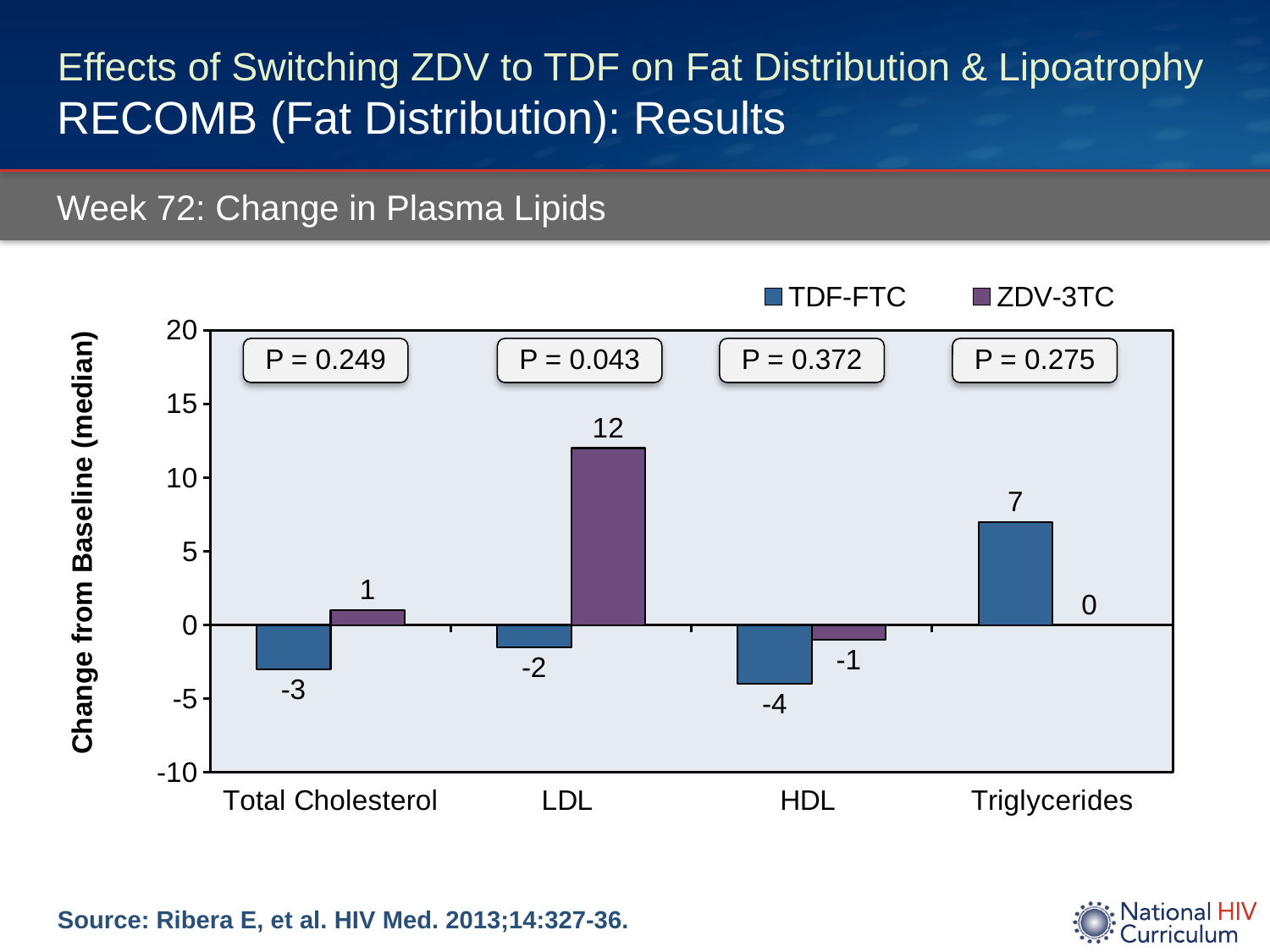
What is the change from baseline for ZDV-3TC in HDL? -1 How many categories are shown on the x axis? 4 What P value is shown above the LDL bars? P = 0.043 Which is larger for Triglycerides, the TDF-FTC value or the ZDV-3TC value? TDF-FTC What is the difference between the ZDV-3TC and TDF-FTC values for LDL? 14 What is the change from baseline for TDF-FTC in Total Cholesterol? -3 Which category has the highest value for ZDV-3TC? LDL What is the change from baseline for ZDV-3TC in LDL? 12 Which category has the lowest value for TDF-FTC? HDL What kind of chart is shown on the slide? Bar chart How many series does the legend list? 2 What is the change from baseline for TDF-FTC in Triglycerides? 7